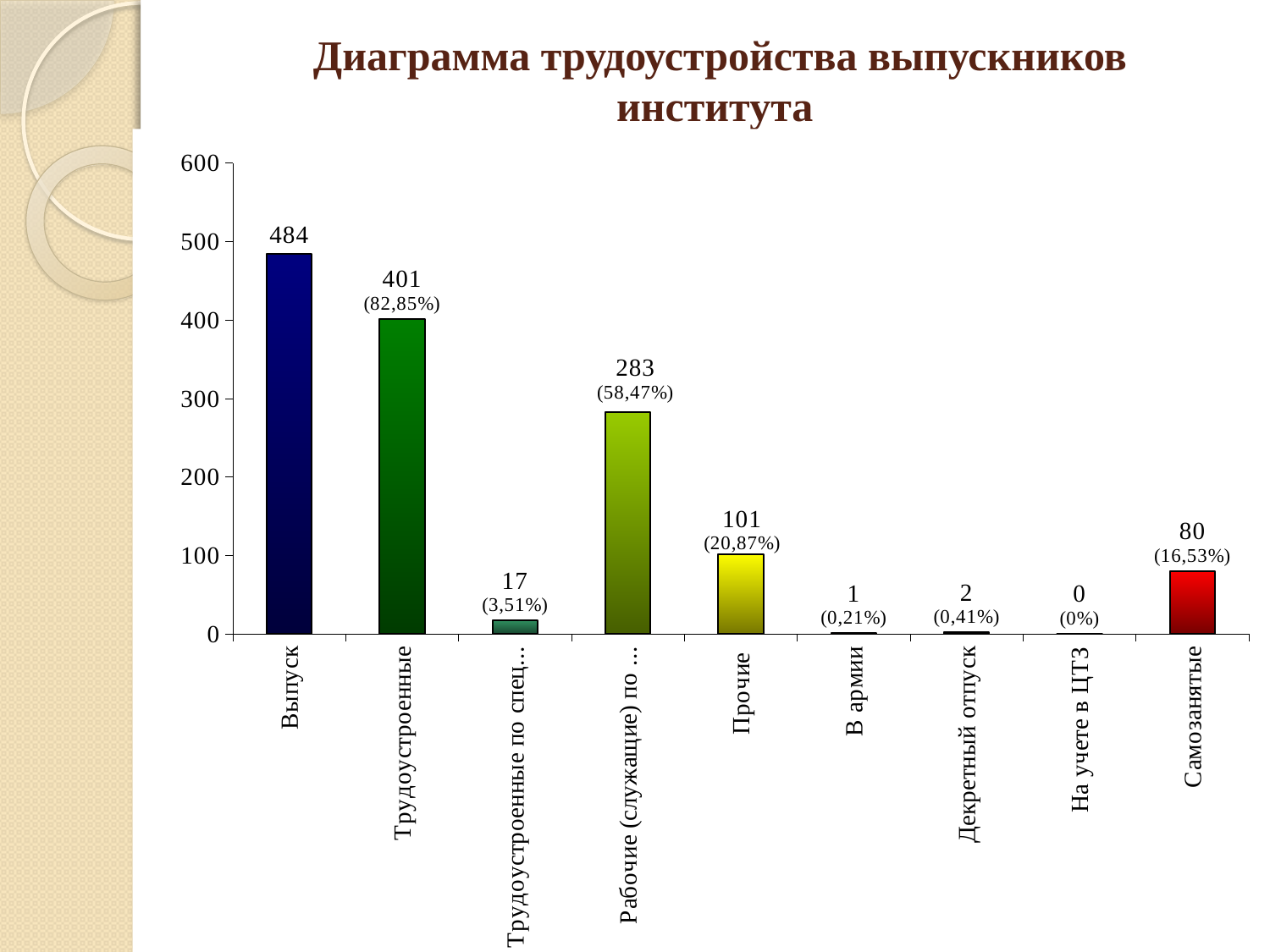
What is the value for Трудоустроенные? 401 Which category has the highest value? Выпуск What kind of chart is shown on the slide? Bar chart What percentage is shown for Самозанятые? 16,53% What is the value for На учете в ЦТЗ? 0 What is the value for Прочие? 101 Which category has the lowest value? На учете в ЦТЗ How many categories are shown on the x axis? 9 What is the difference between the values for Выпуск and Трудоустроенные? 83 What is the value for Выпуск? 484 Which is larger, the value for Прочие or the value for Самозанятые? Прочие What is the title of the chart? Диаграмма трудоустройства выпускников института